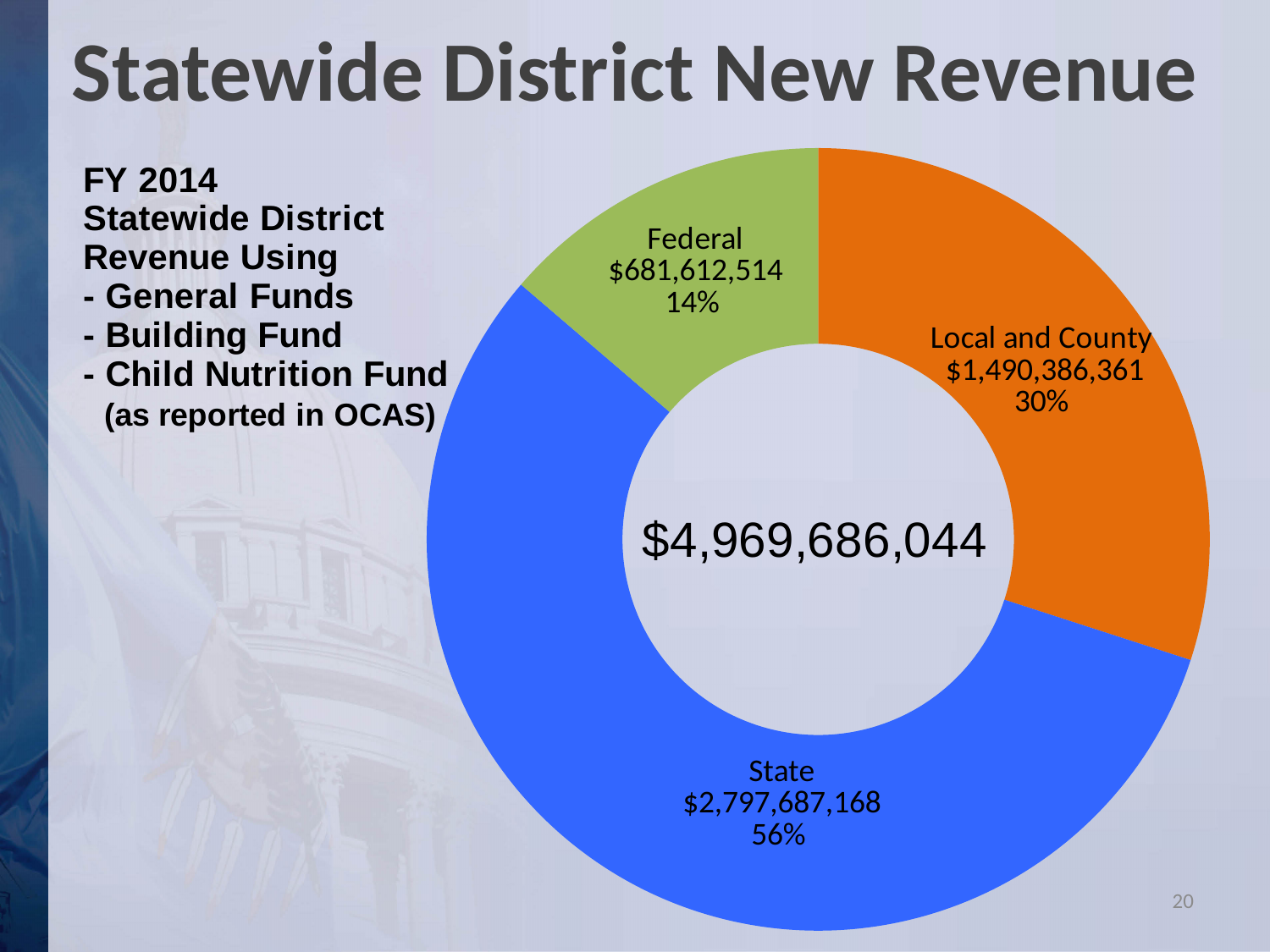
What is the revenue amount for the Local and County slice? $1,490,386,361 Which revenue source has the smallest slice? Federal What percentage share of the total does the State slice represent? 56% What kind of chart is shown on the slide? Pie chart (doughnut) What is the revenue amount for the Federal slice? $681,612,514 Which is larger, the Local and County revenue or the Federal revenue? Local and County What is the difference between the State and Federal revenue amounts? $2,116,074,654 How many slices does the chart have? 3 What percentage share of the total does the Local and County slice represent? 30% What total amount is shown in the center of the chart? $4,969,686,044 Which revenue source has the largest slice? State What is the revenue amount for the State slice? $2,797,687,168